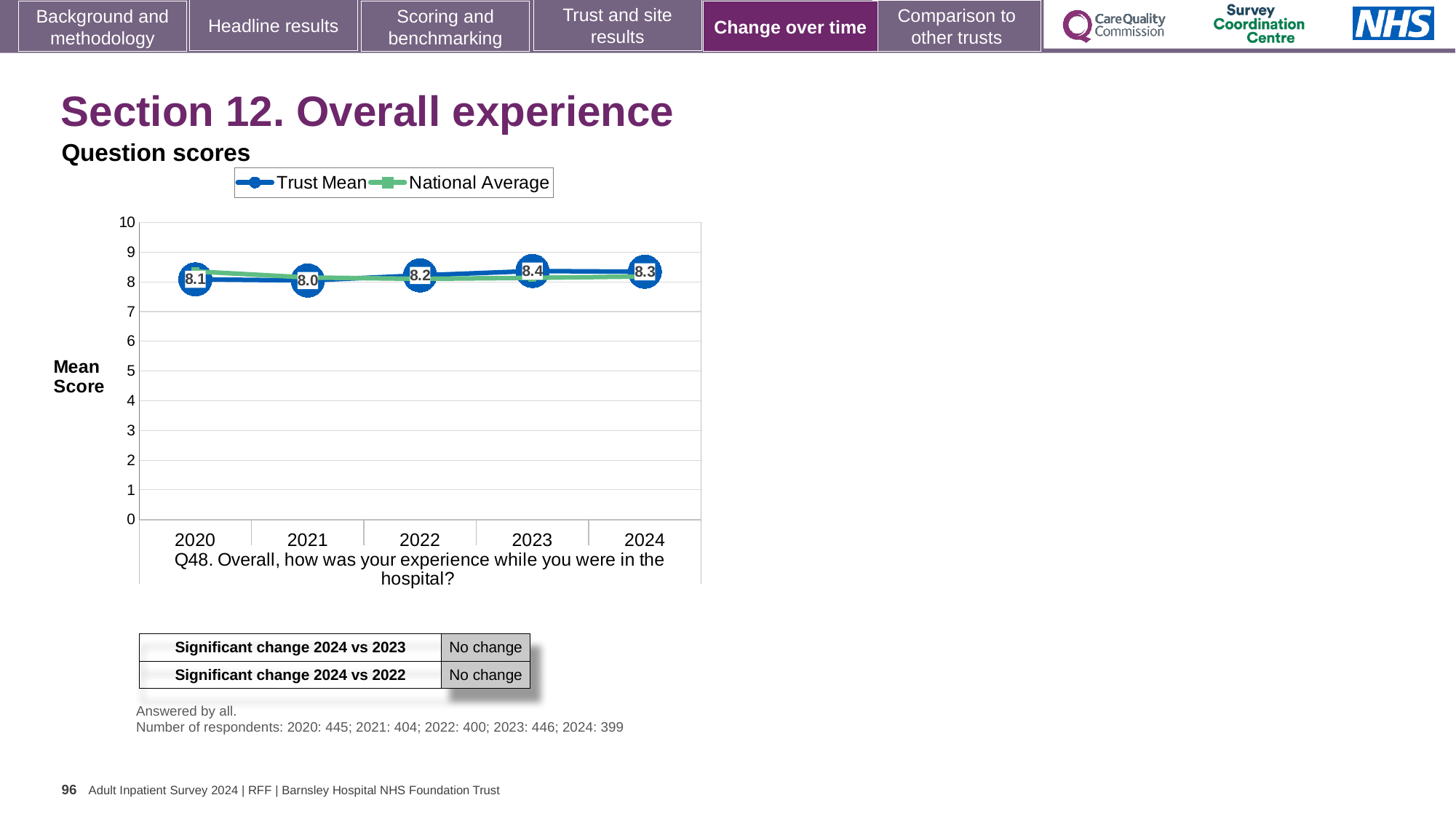
What is the Trust Mean score for 2024? 8.3 What is the Trust Mean score for 2021? 8.0 Is the National Average value for 2020 greater or less than 9? less Which year has the larger Trust Mean score, 2020 or 2022? 2022 In which year is the Trust Mean score lowest? 2021 What kind of chart is shown on the slide? Line chart How many years are shown on the x axis of the chart? 5 In which year is the Trust Mean score highest? 2023 What is the Trust Mean score for 2023? 8.4 What is the difference between the Trust Mean scores for 2023 and 2021? 0.4 How many series does the chart legend list? 2 Does the Trust Mean score rise or fall from 2021 to 2023? Rise